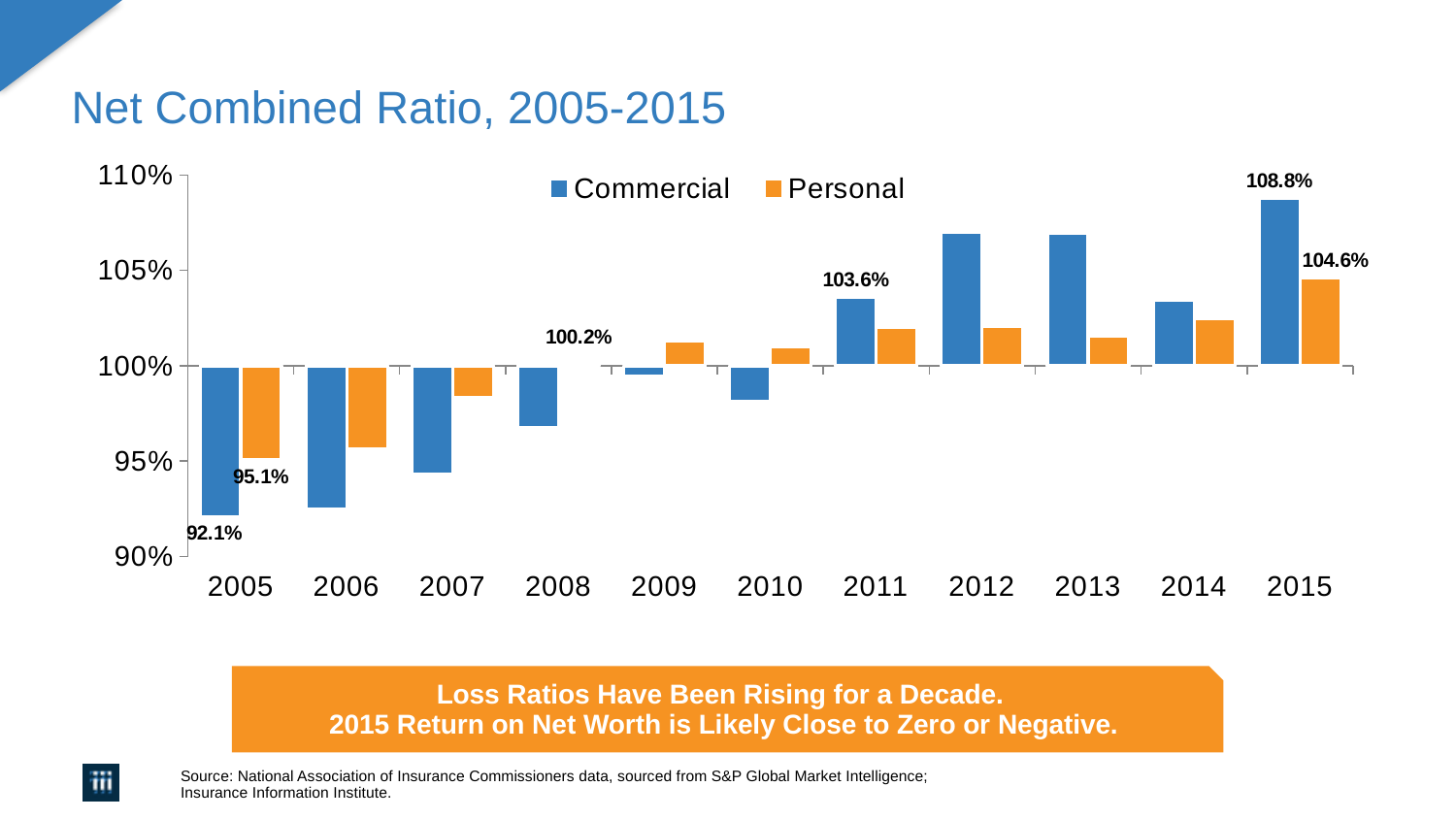
Which series is shown in orange in the legend? Personal What is the Commercial net combined ratio for 2011? 103.6% What is the Commercial net combined ratio for 2015? 108.8% What is the difference between the Commercial and Personal net combined ratios in 2015? 4.2 percentage points What is the Personal net combined ratio for 2005? 95.1% In which year is the Commercial net combined ratio highest? 2015 What kind of chart is shown on the slide? Bar chart What is the Commercial net combined ratio for 2005? 92.1% Is the Commercial net combined ratio for 2010 greater or less than 100%? less How many years are shown on the x axis? 11 What is the Personal net combined ratio for 2015? 104.6% How many series does the legend list? 2